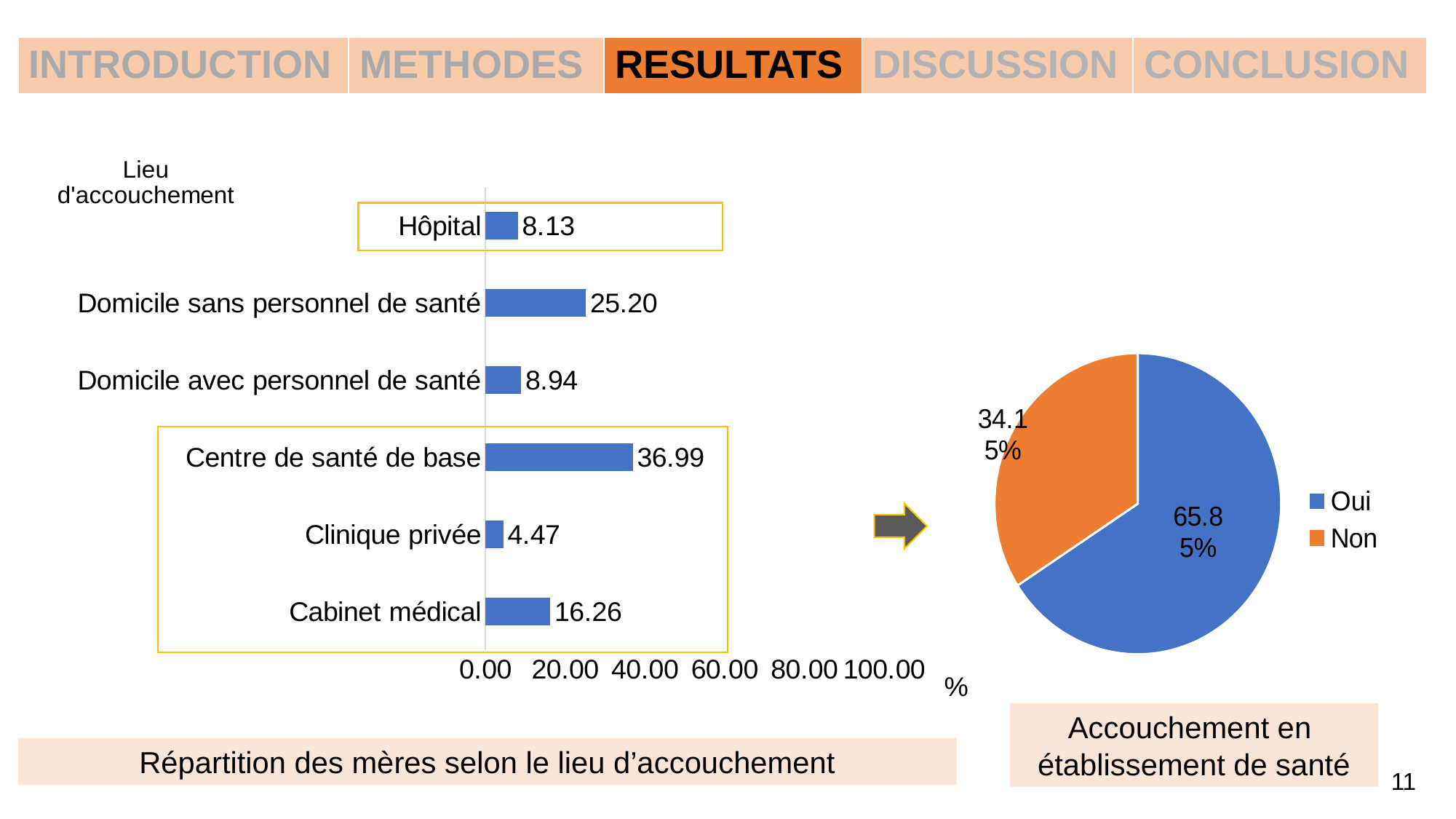
In the bar chart 'Répartition des mères selon le lieu d'accouchement', what is the value for Centre de santé de base? 36.99 In the bar chart 'Répartition des mères selon le lieu d'accouchement', what is the difference between Centre de santé de base and Cabinet médical? 20.73 In the bar chart 'Répartition des mères selon le lieu d'accouchement', what is the value for Hôpital? 8.13 How many categories are shown in the bar chart 'Répartition des mères selon le lieu d'accouchement'? 6 In the bar chart 'Répartition des mères selon le lieu d'accouchement', which is larger: Domicile avec personnel de santé or Hôpital? Domicile avec personnel de santé What kind of chart is 'Répartition des mères selon le lieu d'accouchement'? bar chart In the bar chart 'Répartition des mères selon le lieu d'accouchement', which category has the lowest value? Clinique privée In the bar chart 'Répartition des mères selon le lieu d'accouchement', what is the value for Domicile sans personnel de santé? 25.20 In the bar chart 'Répartition des mères selon le lieu d'accouchement', which category has the highest value? Centre de santé de base In the pie chart 'Accouchement en établissement de santé', what share does Oui have? 65.85% How many series does the legend of the pie chart 'Accouchement en établissement de santé' list? 2 In the bar chart 'Répartition des mères selon le lieu d'accouchement', is the value for Domicile sans personnel de santé greater or less than 20.00? greater